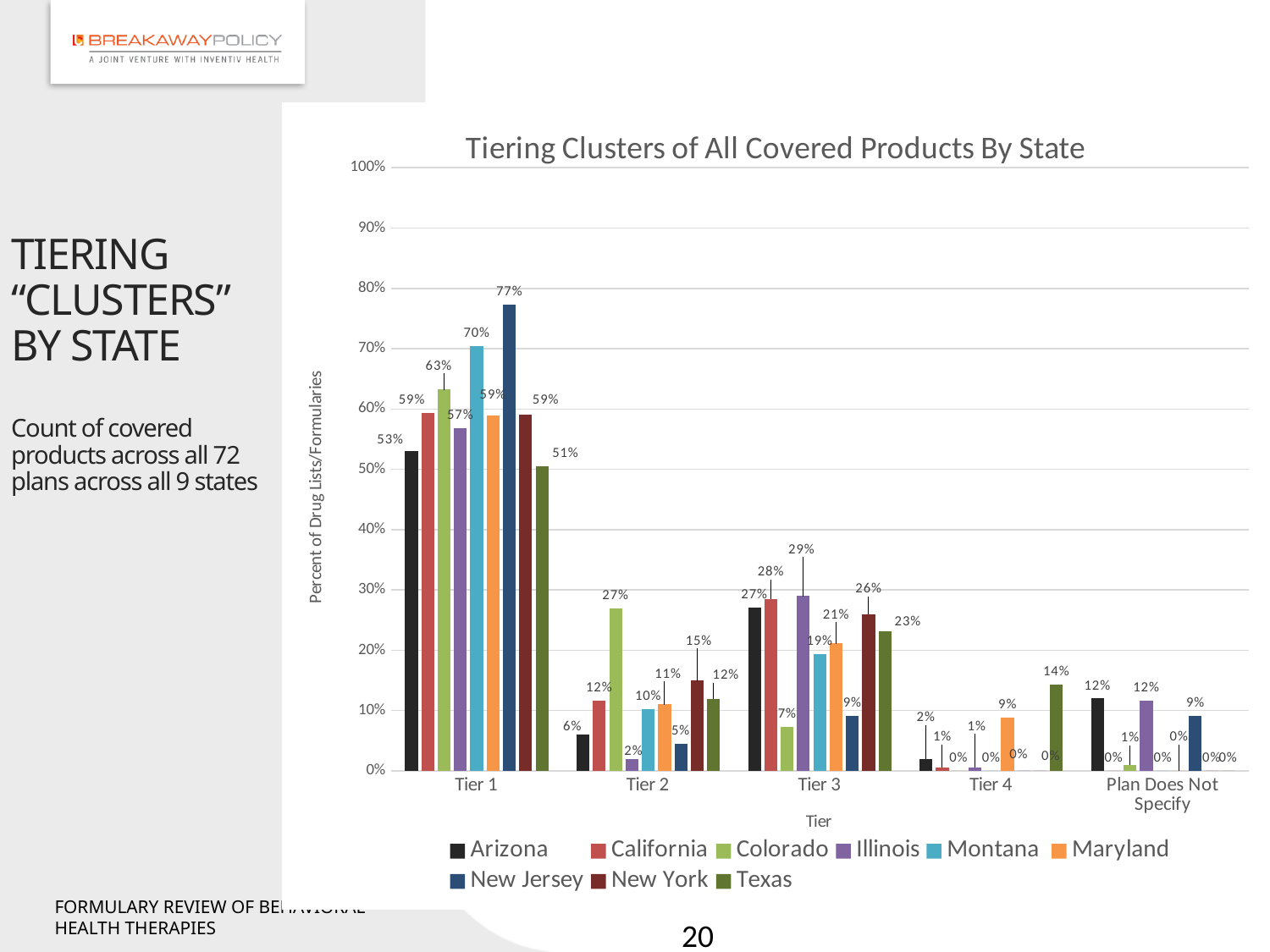
What is the difference between Montana's Tier 1 value and Arizona's Tier 1 value? 17% What is the Tier 2 value for Colorado? 27% What is the Tier 1 value for New Jersey? 77% What type of chart is shown on the slide? Bar chart Which state has the highest Tier 1 value? New Jersey Which is larger for Tier 3: Illinois or Colorado? Illinois How many series does the legend list? 9 How many tier categories are shown on the x axis? 5 What is the title of the chart? Tiering Clusters of All Covered Products By State Which state has the lowest Tier 1 value? Texas Is the Tier 1 value for Colorado greater or less than 60%? greater What is the Tier 3 value for Montana? 19%